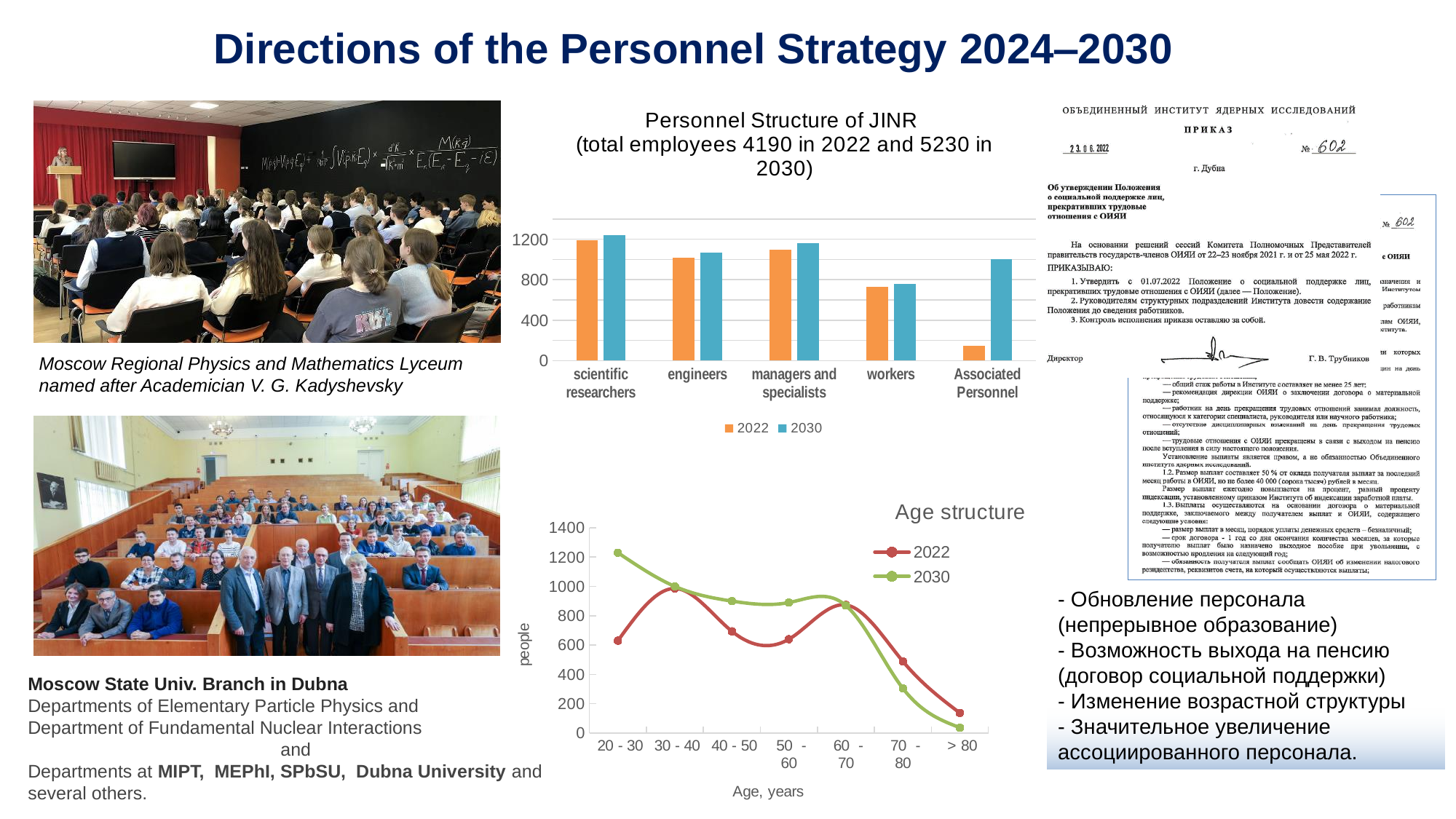
In the Personnel Structure of JINR chart, which category has the lowest value for 2022? Associated Personnel In the Personnel Structure of JINR chart, is the 2022 value for Associated Personnel greater or less than 400? less In the Personnel Structure of JINR chart, what kind of chart is used? bar chart In the Age structure chart, what kind of chart is used? line chart In the Personnel Structure of JINR chart, how many personnel categories are shown on the x axis? 5 In the Age structure chart, how many age groups are shown on the x axis? 7 In the Age structure chart, which age group has the highest value for 2030? 20 - 30 In the Personnel Structure of JINR chart, how many series does the legend list? 2 In the Personnel Structure of JINR chart, which category has the highest value for 2030? scientific researchers In the Age structure chart, is the 2022 value for the > 80 age group greater or less than 200? less In the Personnel Structure of JINR chart, which is larger for Associated Personnel: the 2022 value or the 2030 value? 2030